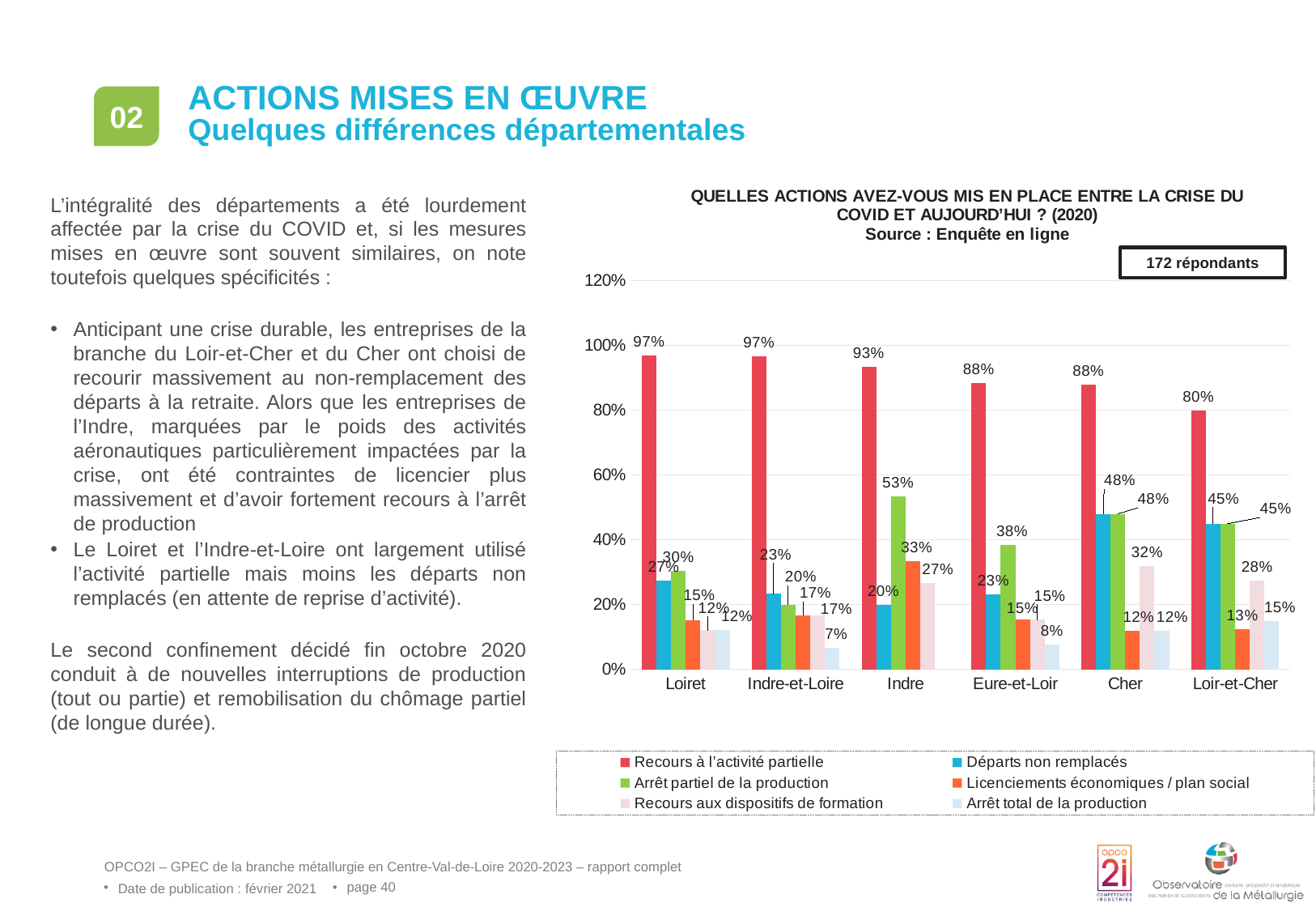
Which department has the lowest value for Recours à l'activité partielle? Loir-et-Cher What is the value for Recours à l'activité partielle in Loiret? 97% What is the difference between the Recours à l'activité partielle values for Loiret and Loir-et-Cher? 17 percentage points What is the value for Licenciements économiques / plan social in Indre? 33% Which has a higher value for Arrêt partiel de la production, Indre or Eure-et-Loir? Indre How many series does the legend list? 6 What is the value for Arrêt partiel de la production in Indre? 53% How many respondents does the chart indicate? 172 répondants How many departments are shown on the x axis? 6 Which department has the highest value for Départs non remplacés? Cher What is the value for Arrêt total de la production in Indre-et-Loire? 7% What kind of chart is shown on the slide? Bar chart